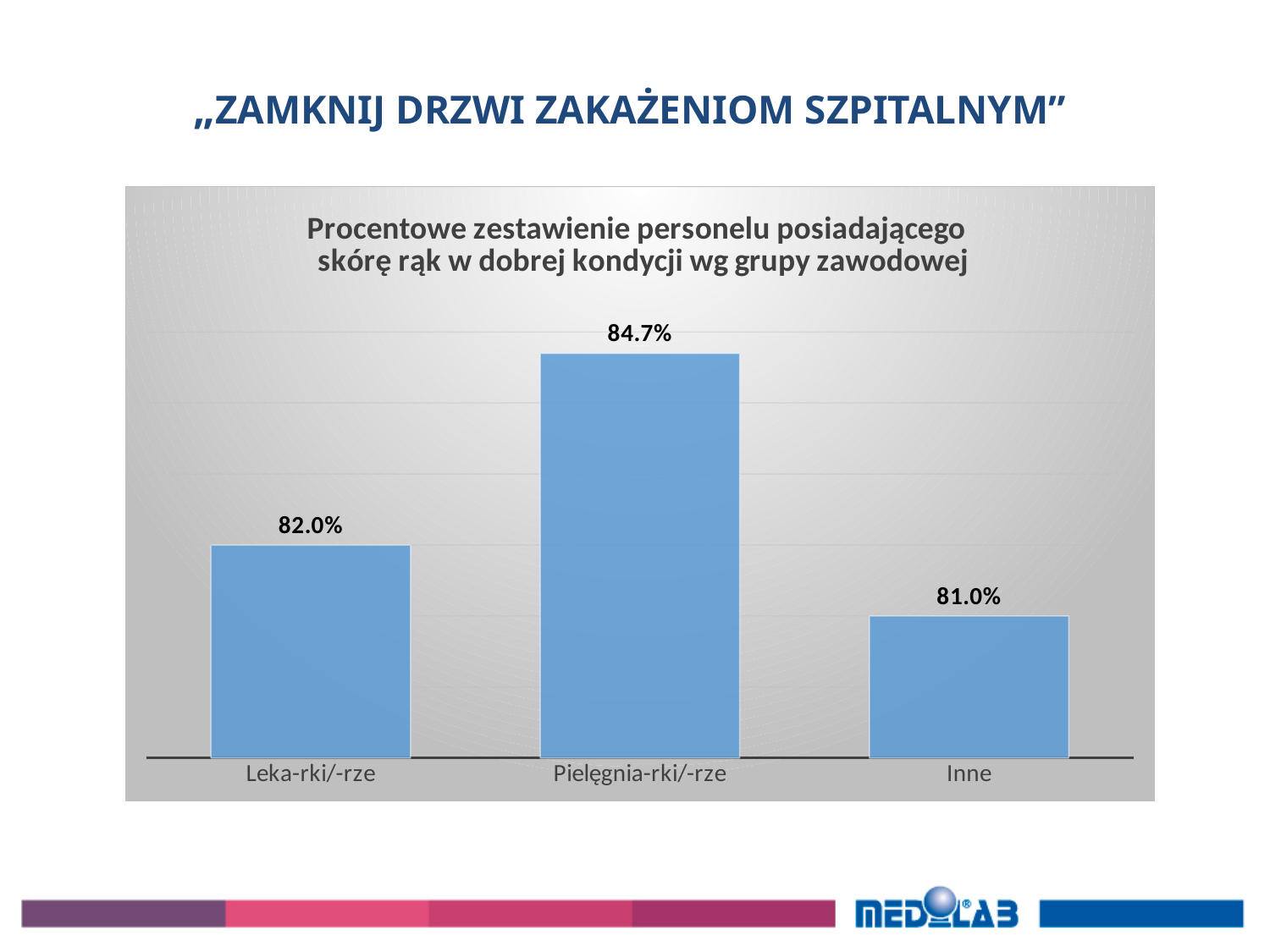
Which is larger, the value for Leka-rki/-rze or the value for Pielęgnia-rki/-rze? Pielęgnia-rki/-rze What is the value for Inne? 81.0% What kind of chart is shown on the slide? Bar chart What is the title of the chart? Procentowe zestawienie personelu posiadającego skórę rąk w dobrej kondycji wg grupy zawodowej Which category has the highest value? Pielęgnia-rki/-rze What colour are the bars in the chart? Blue How many categories are shown on the chart? 3 Which category has the lowest value? Inne What is the difference between the values for Pielęgnia-rki/-rze and Inne? 3.7% What is the difference between the values for Leka-rki/-rze and Inne? 1.0% What is the value for Pielęgnia-rki/-rze? 84.7% What is the value for Leka-rki/-rze? 82.0%